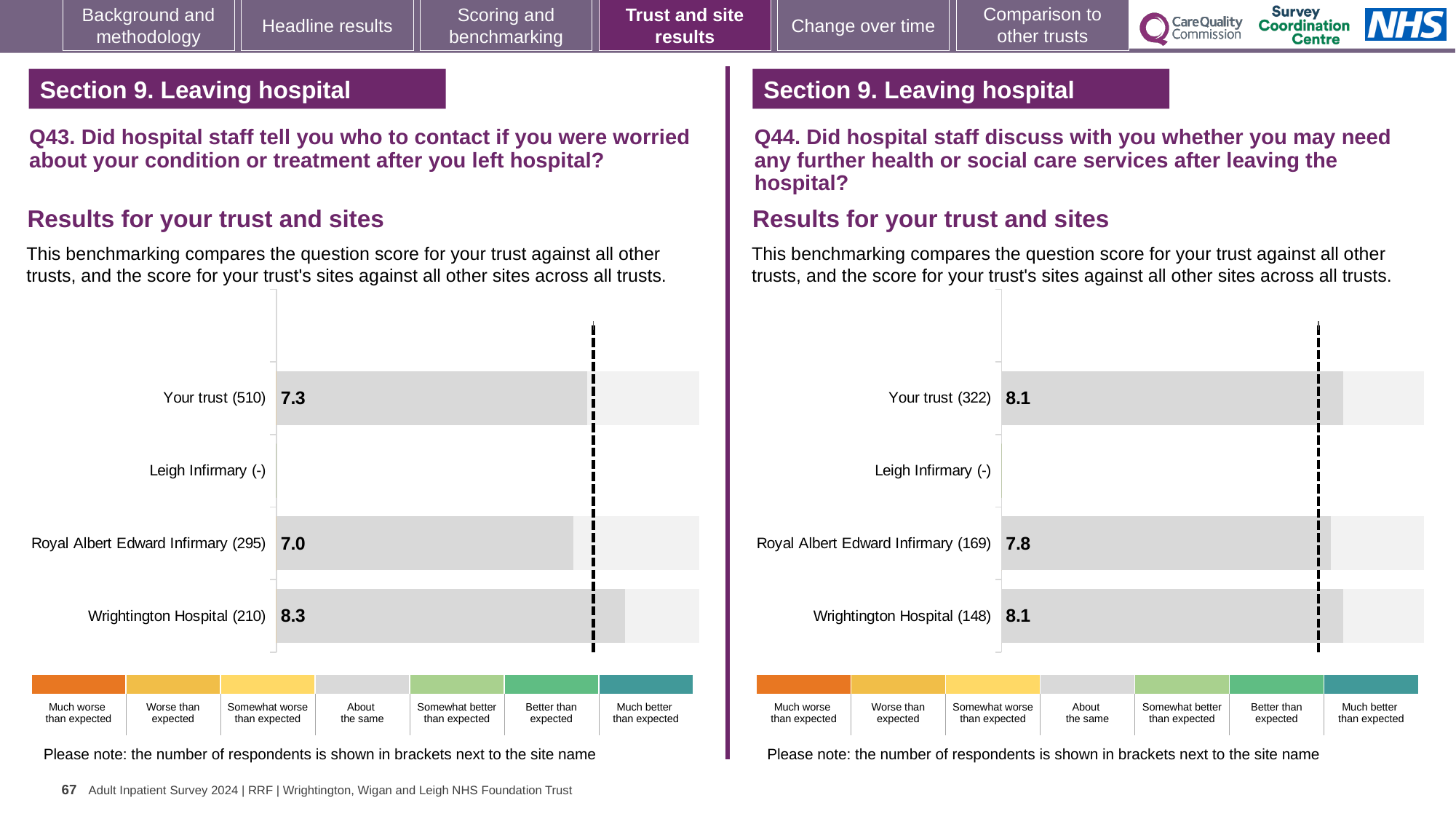
In the Q44 chart on the right, which is larger: the score for Your trust or the score for Royal Albert Edward Infirmary? Your trust In the Q44 chart on the right, what is the score for Your trust? 8.1 In the Q44 chart on the right, what is the score for Royal Albert Edward Infirmary? 7.8 In the Q43 chart on the left, what is the score for Wrightington Hospital? 8.3 In the Q43 chart on the left, which site has the lowest score shown? Royal Albert Edward Infirmary What kind of chart is used in the Q44 chart on the right? Bar chart In the Q43 chart on the left, what is the score for Your trust? 7.3 In the Q43 chart on the left, what is the difference between the scores for Wrightington Hospital and Royal Albert Edward Infirmary? 1.3 How many site/trust rows are listed in the Q43 chart on the left? 4 In the Q44 chart on the right, how many respondents are shown in brackets for Wrightington Hospital? 148 In the Q43 chart on the left, how many respondents are shown in brackets for Your trust? 510 In the Q44 chart on the right, what is the difference between the scores for Wrightington Hospital and Royal Albert Edward Infirmary? 0.3